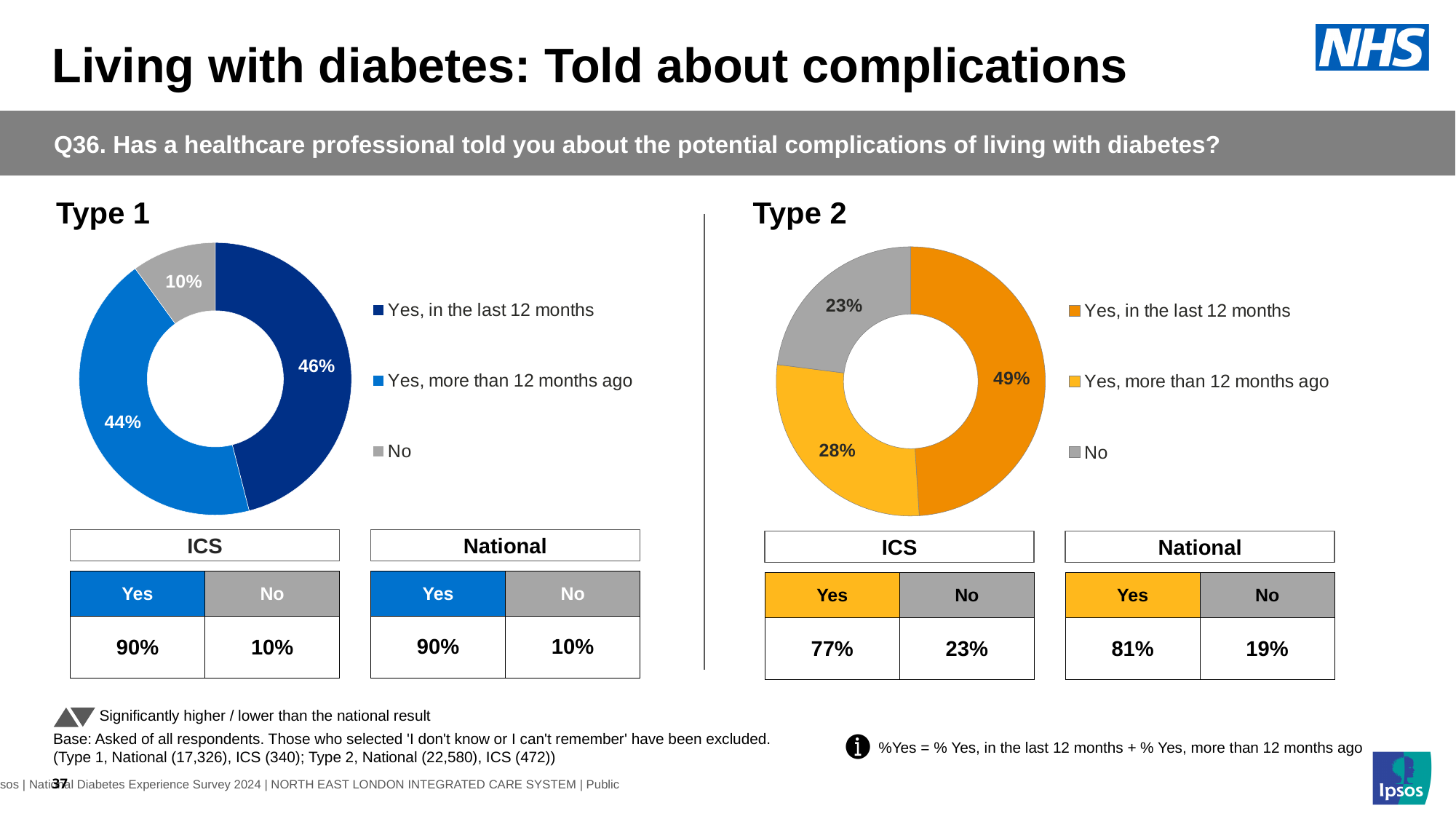
Is the 'No' share in the Type 2 chart larger or smaller than the 'No' share in the Type 1 chart? larger In the Type 2 chart, what percentage of respondents said 'No'? 23% In the Type 2 chart, what is the difference between 'Yes, in the last 12 months' and 'Yes, more than 12 months ago'? 21 percentage points Which is larger in the Type 1 chart: 'Yes, in the last 12 months' or 'Yes, more than 12 months ago'? Yes, in the last 12 months In the Type 2 chart, what is the combined share of the two 'Yes' categories? 77% In the Type 1 chart, what percentage of respondents said 'Yes, in the last 12 months'? 46% What colour represents 'No' in the Type 1 chart? Grey In the Type 2 chart, which category has the largest share? Yes, in the last 12 months In the Type 1 chart, which category has the smallest share? No What kind of chart is used for Type 2? Doughnut (pie) chart How many categories does the Type 1 chart show? 3 In the Type 1 chart, what percentage of respondents said 'Yes, more than 12 months ago'? 44%